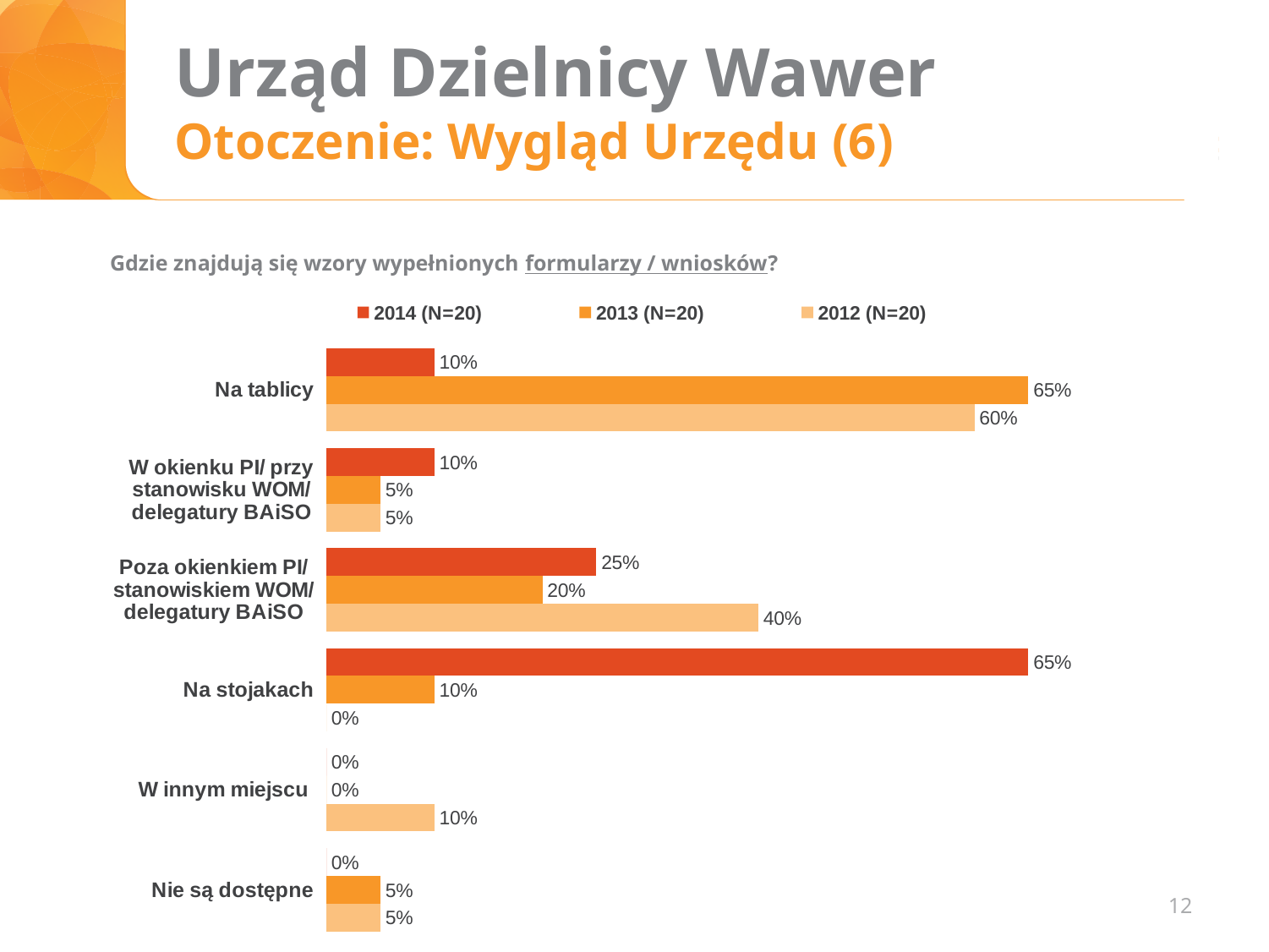
What is the difference between the 2013 (N=20) and 2014 (N=20) values for "Na tablicy"? 55% Which category has the highest value in the 2014 (N=20) series? Na stojakach How many categories are shown on the chart? 6 How many series does the legend list? 3 What is the value for "Poza okienkiem PI/ stanowiskiem WOM/ delegatury BAiSO" in the 2012 (N=20) series? 40% What kind of chart is shown on the slide? Bar chart Which is larger for "Na stojakach": the 2014 (N=20) value or the 2013 (N=20) value? 2014 (N=20) What is the value for "Na tablicy" in the 2013 (N=20) series? 65% What is the value for "Na stojakach" in the 2014 (N=20) series? 65% What is the difference between the 2012 (N=20) and 2013 (N=20) values for "Poza okienkiem PI/ stanowiskiem WOM/ delegatury BAiSO"? 20% Which category has the highest value in the 2012 (N=20) series? Na tablicy What is the value for "W innym miejscu" in the 2012 (N=20) series? 10%